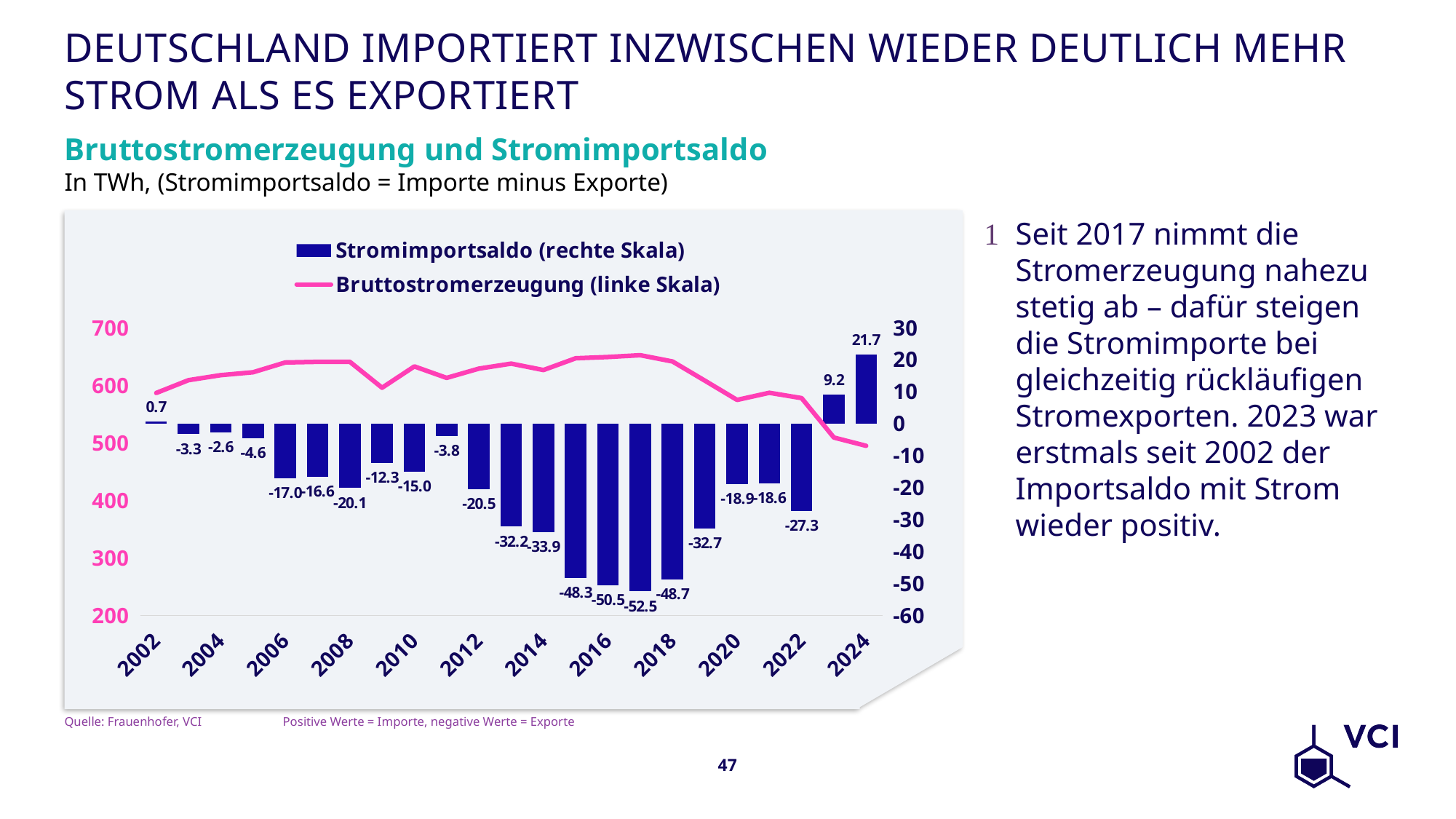
Is the Bruttostromerzeugung value for 2016 greater or less than 600? greater In which year is the Stromimportsaldo highest? 2024 What is the Stromimportsaldo value for 2017? -52.5 How many series does the chart legend list? 2 What is the Stromimportsaldo value for 2024? 21.7 Is the Bruttostromerzeugung value for 2002 greater or less than 600? less What is the difference between the Stromimportsaldo values for 2024 and 2023? 12.5 How many years are plotted on the x axis of the chart? 23 What kind of chart is shown on the slide? Combined bar and line chart What is the Stromimportsaldo value for 2002? 0.7 Which year has the larger Stromimportsaldo value, 2006 or 2012? 2006 In which year is the Stromimportsaldo lowest? 2017